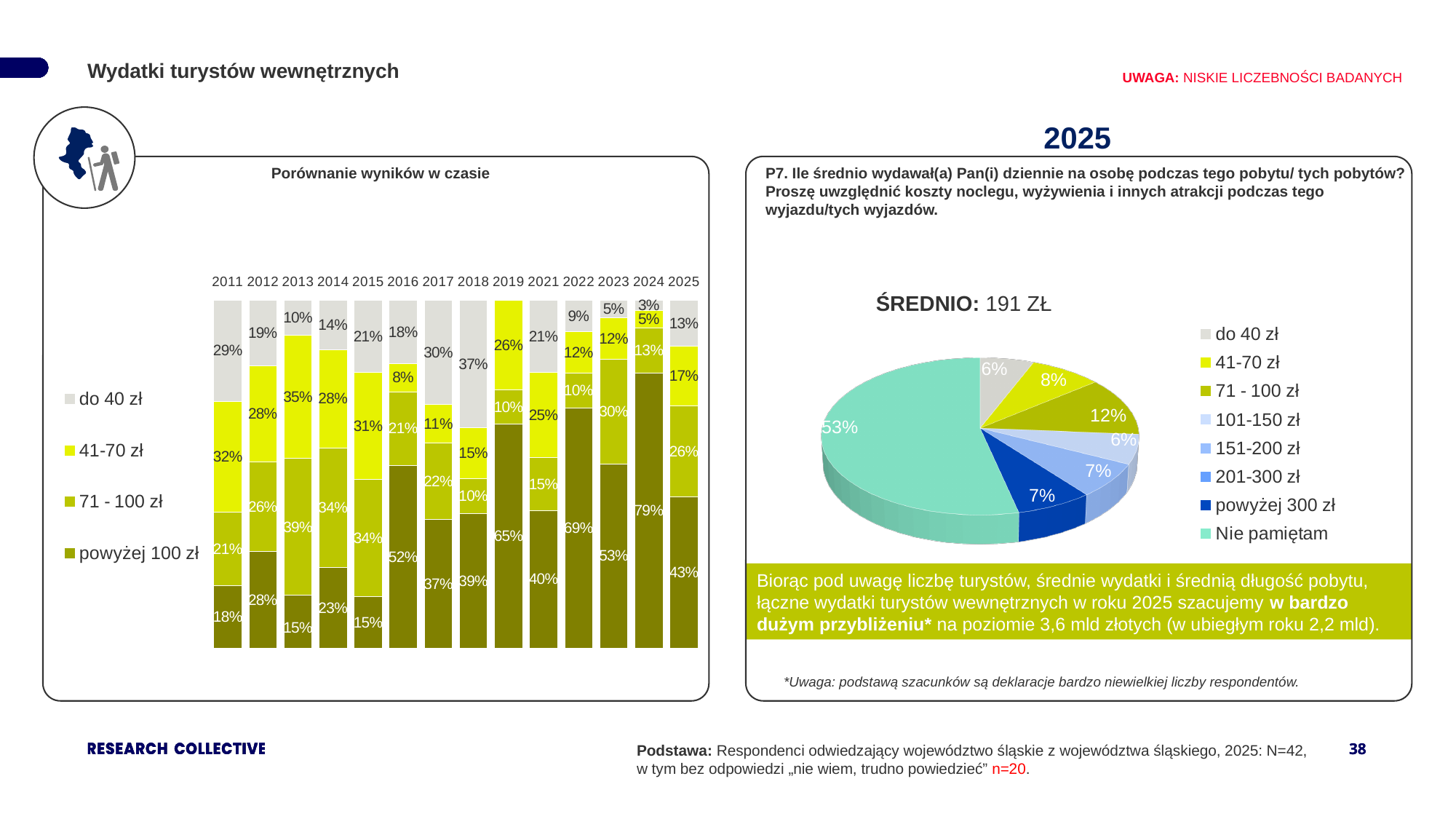
In the pie chart on the right (2025), what share is "Nie pamiętam"? 53% In the left chart "Porównanie wyników w czasie", how many years are shown on the x axis? 14 In the left chart "Porównanie wyników w czasie", what is the value for "do 40 zł" in 2025? 13% In the left chart "Porównanie wyników w czasie", what is the value for "do 40 zł" in 2018? 37% In the pie chart on the right (2025), which category has the largest slice? Nie pamiętam In the left chart "Porównanie wyników w czasie", by how many percentage points did the "powyżej 100 zł" share fall from 2024 to 2025? 36 percentage points In the left chart "Porównanie wyników w czasie", what is the value for "powyżej 100 zł" in 2024? 79% In the left chart "Porównanie wyników w czasie", which year has the highest share for "powyżej 100 zł"? 2024 In the left chart "Porównanie wyników w czasie", which year has the larger share for "41-70 zł": 2011 or 2025? 2011 How many entries does the legend of the pie chart on the right (2025) list? 8 What kind of chart is the left chart titled "Porównanie wyników w czasie"? Stacked bar chart How many series does the legend of the left chart "Porównanie wyników w czasie" list? 4